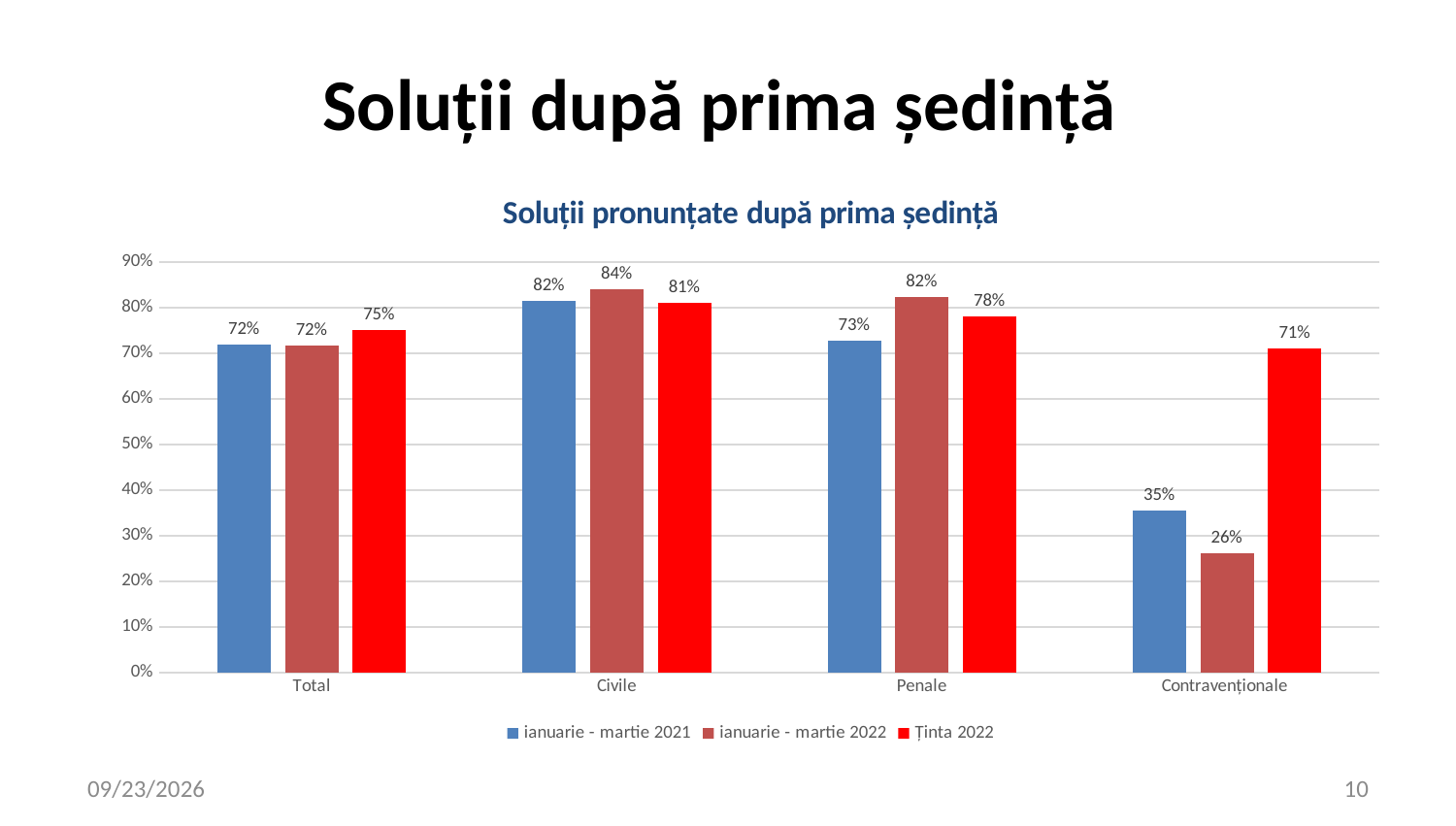
Which is larger for Penale: the ianuarie - martie 2022 value or the Ținta 2022 value? ianuarie - martie 2022 Which category has the lowest value in the ianuarie - martie 2022 series? Contravenționale What is the difference between the ianuarie - martie 2021 and ianuarie - martie 2022 values for Contravenționale? 9% What is the title of the chart? Soluții pronunțate după prima ședință What is the value for Civile in the ianuarie - martie 2022 series? 84% What is the Ținta 2022 value for Contravenționale? 71% How many series does the legend list? 3 Which category has the highest Ținta 2022 value? Civile Is the ianuarie - martie 2022 value for Contravenționale greater or less than 30%? less What kind of chart is shown on the slide? bar chart How many categories are shown on the x axis? 4 What is the value for Penale in the ianuarie - martie 2021 series? 73%